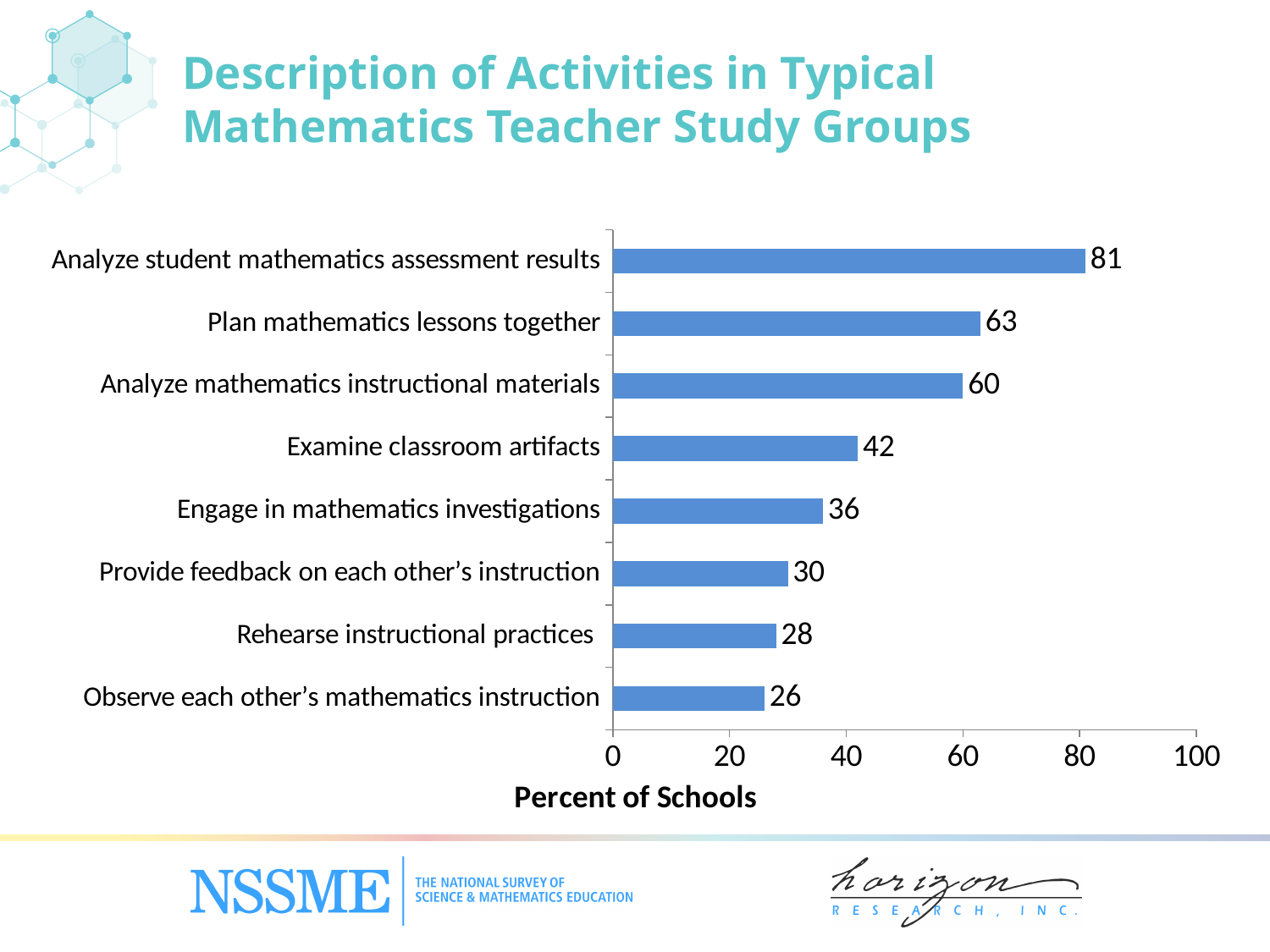
Which activity has the lowest percent of schools? Observe each other's mathematics instruction Which is larger: the value for 'Analyze mathematics instructional materials' or 'Examine classroom artifacts'? Analyze mathematics instructional materials What is the difference between the values for 'Examine classroom artifacts' and 'Rehearse instructional practices'? 14 What is the label of the horizontal axis? Percent of Schools How many activities are shown in the chart? 8 What percent of schools report that study groups engage in mathematics investigations? 36 What is the value for 'Plan mathematics lessons together'? 63 Is the value for 'Provide feedback on each other's instruction' greater or less than 40? less Which activity has the highest percent of schools? Analyze student mathematics assessment results What is the difference between the values for 'Analyze student mathematics assessment results' and 'Plan mathematics lessons together'? 18 What kind of chart is shown on the slide? Bar chart What percent of schools report that teacher study groups analyze student mathematics assessment results? 81